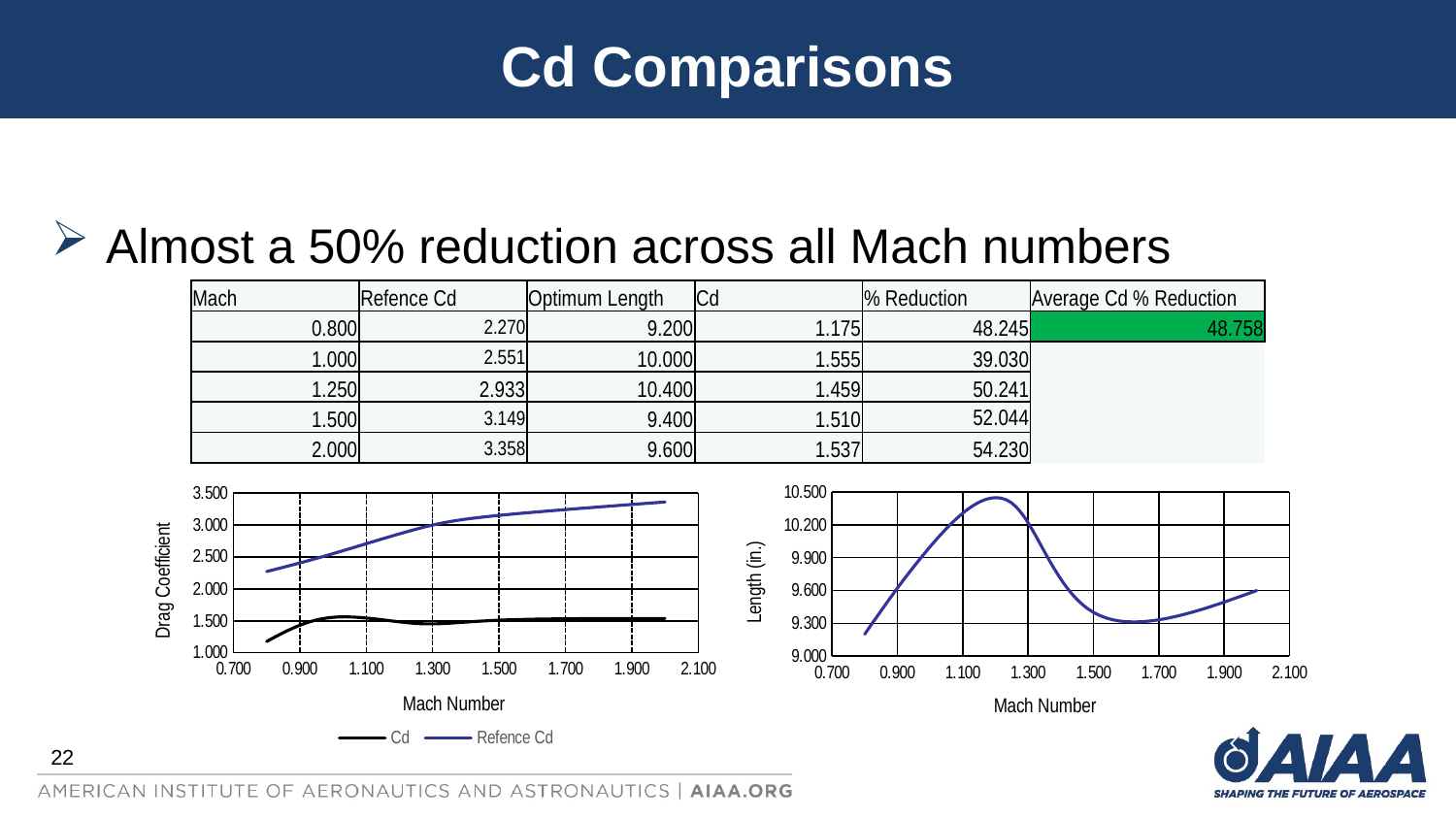
In the right chart (Length (in.) vs Mach Number), is the value at the start of the line (Mach 0.800) greater or less than 9.300? less In the right chart (Length (in.) vs Mach Number), is the value at Mach 1.700 greater or less than 9.600? less In the left chart (Drag Coefficient vs Mach Number), is the Refence Cd value at Mach 2.100 end of the line (Mach 2.000) greater or less than 3.000? greater What kind of chart is the right chart (Length (in.) vs Mach Number)? line chart What kind of chart is the left chart (Drag Coefficient vs Mach Number)? line chart In the left chart (Drag Coefficient vs Mach Number), does the Refence Cd line rise or fall as Mach Number increases? rises In the left chart (Drag Coefficient vs Mach Number), which series is higher at Mach 1.500, Cd or Refence Cd? Refence Cd How many series does the legend of the left chart (Drag Coefficient vs Mach Number) list? 2 What are the two series named in the legend of the left chart (Drag Coefficient vs Mach Number)? Cd and Refence Cd What is the y-axis title of the right chart? Length (in.)